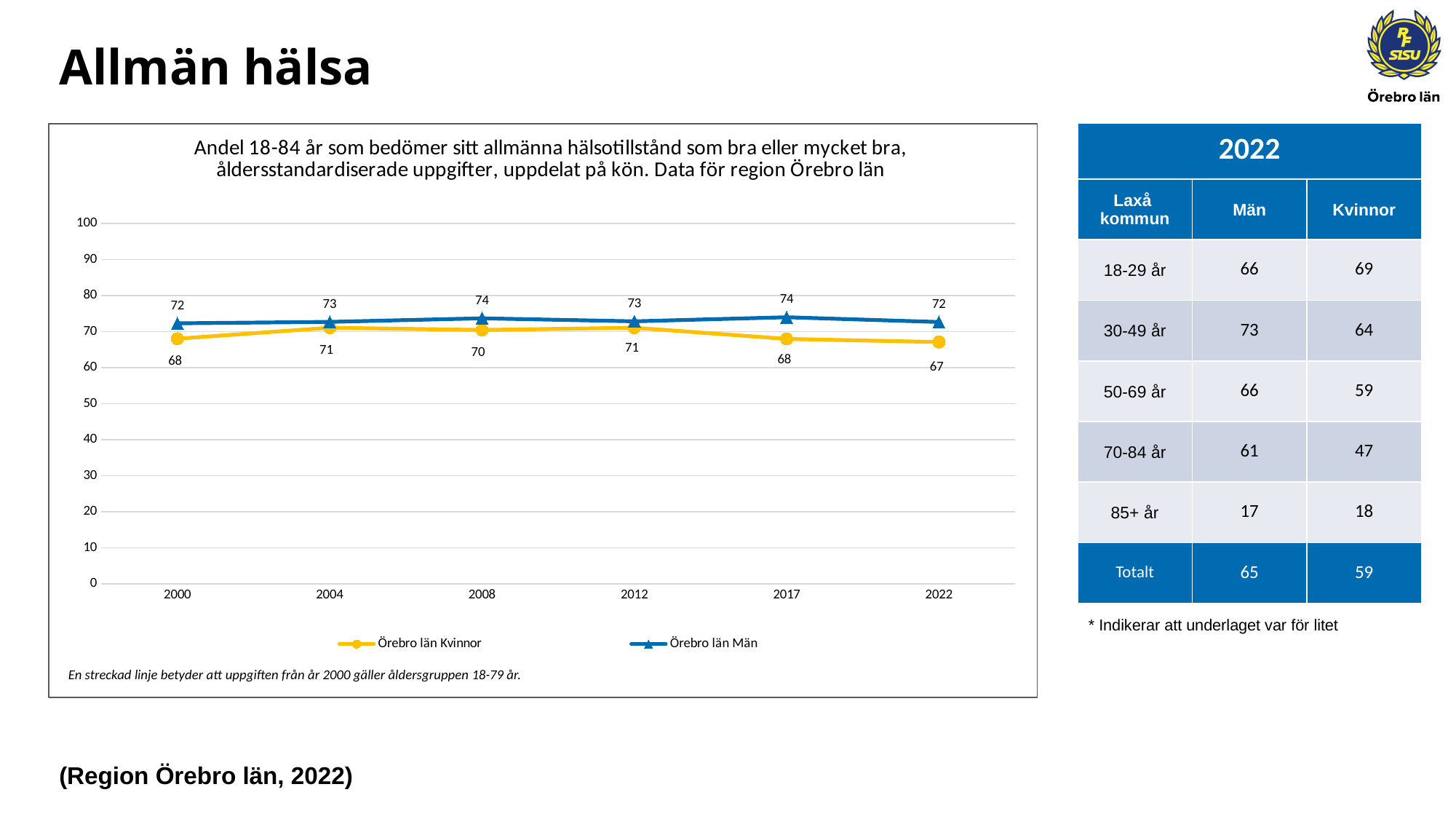
In which year is the Örebro län Kvinnor series at its lowest? 2022 What is the value for Örebro län Kvinnor in 2000? 68 Does the Örebro län Kvinnor series rise or fall from 2012 to 2022? Fall What is the value for Örebro län Kvinnor in 2022? 67 Which colour is used for the Örebro län Män series in the chart? Blue What is the value for Örebro län Män in 2017? 74 What kind of chart is shown on the slide? Line chart Which series has the higher value in 2017, Örebro län Kvinnor or Örebro län Män? Örebro län Män What is the difference between Örebro län Män and Örebro län Kvinnor in 2022? 5 What is the difference between Örebro län Män in 2008 and in 2000? 2 How many years are shown on the x axis of the chart? 6 How many series does the chart legend list? 2